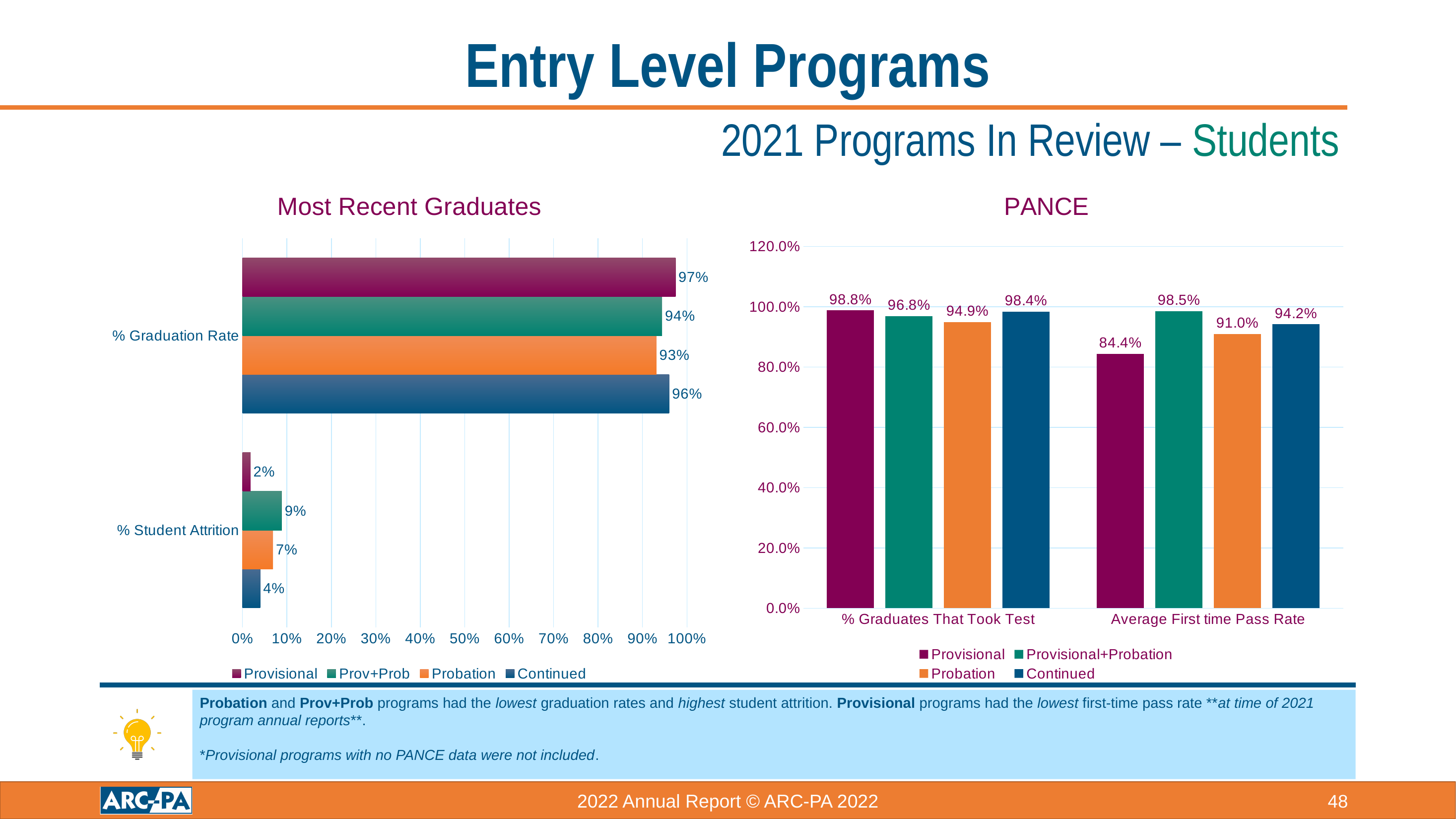
In the 'PANCE' chart, what is the difference between the Average First time Pass Rate for Provisional+Probation and Probation programs? 7.5% In the 'Most Recent Graduates' chart, which series has the lowest % Graduation Rate? Probation What kind of chart is the 'Most Recent Graduates' chart? Bar chart In the 'PANCE' chart, which is larger: the % Graduates That Took Test for Probation or for Continued programs? Continued In the 'Most Recent Graduates' chart, what is the % Graduation Rate for Provisional programs? 97% In the 'PANCE' chart, how many categories are shown on the x axis? 2 In the 'Most Recent Graduates' chart, what is the % Student Attrition for Prov+Prob programs? 9% In the 'PANCE' chart, which series has the highest Average First time Pass Rate? Provisional+Probation In the 'Most Recent Graduates' chart, what is the difference between the % Student Attrition for Prov+Prob and Provisional programs? 7% In the 'PANCE' chart, what is the Average First time Pass Rate for Provisional programs? 84.4% In the 'PANCE' chart, what is the % Graduates That Took Test for Continued programs? 98.4% In the 'Most Recent Graduates' chart, how many series does the legend list? 4